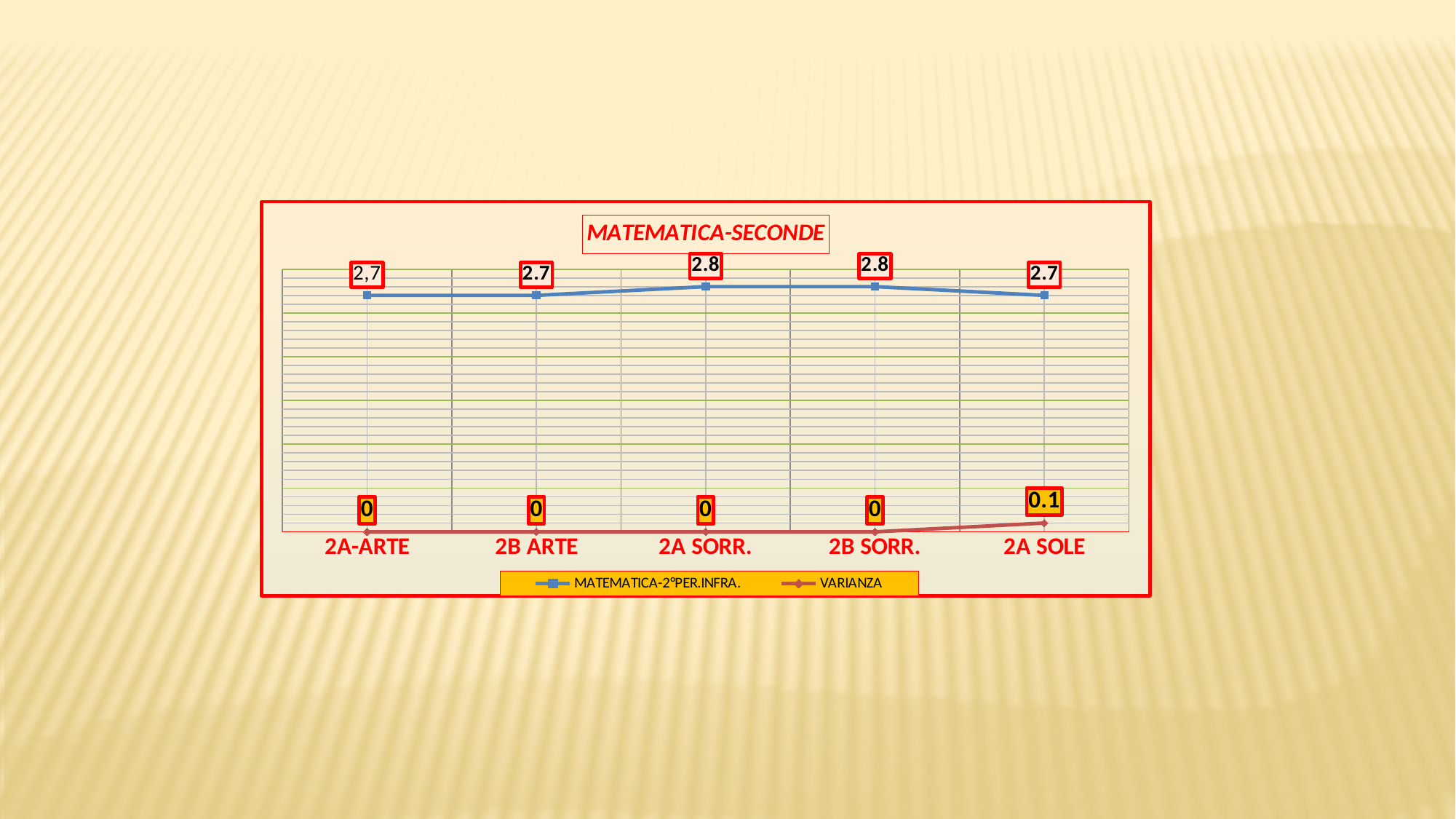
What type of chart is shown on the slide? line chart Which is larger, the MATEMATICA-2°PER.INFRA. value for 2B ARTE or for 2A SORR.? 2A SORR. How many series does the legend list? 2 What is the title of the chart? MATEMATICA-SECONDE Which category has the highest VARIANZA value? 2A SOLE What is the difference between the MATEMATICA-2°PER.INFRA. values for 2B SORR. and 2A SOLE? 0.1 Which series is drawn in blue? MATEMATICA-2°PER.INFRA. What is the MATEMATICA-2°PER.INFRA. value for 2A SOLE? 2.7 What is the VARIANZA value for 2B ARTE? 0 What is the VARIANZA value for 2A SOLE? 0.1 What is the MATEMATICA-2°PER.INFRA. value for 2A SORR.? 2.8 How many categories are shown on the x axis? 5